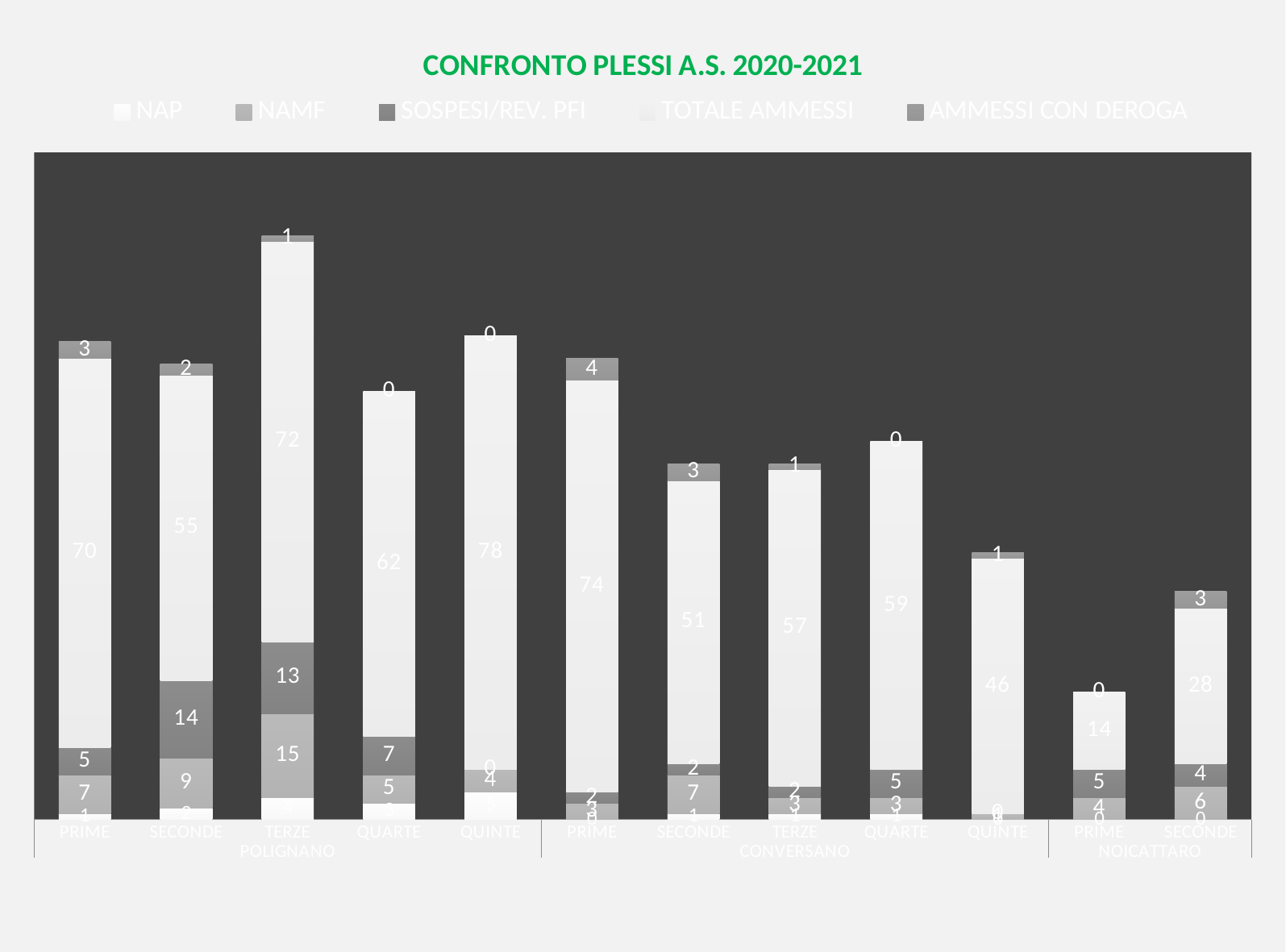
What is the TOTALE AMMESSI value for PRIME in CONVERSANO? 74 What is the title of the chart? CONFRONTO PLESSI A.S. 2020-2021 Which class group has the lowest TOTALE AMMESSI value? PRIME (NOICATTARO) Which is larger: the NAMF value for TERZE in POLIGNANO or the NAMF value for SECONDE in POLIGNANO? TERZE in POLIGNANO What is the AMMESSI CON DEROGA value for PRIME in CONVERSANO? 4 How many class groups (bars) are plotted across the three plessi? 12 What type of chart is shown on the slide? stacked bar chart What is the TOTALE AMMESSI value for QUINTE in POLIGNANO? 78 What is the difference between the TOTALE AMMESSI values for PRIME in CONVERSANO and PRIME in POLIGNANO? 4 How many series does the legend list? 5 What is the SOSPESI/REV. PFI value for SECONDE in POLIGNANO? 14 Which class group has the highest TOTALE AMMESSI value? QUINTE (POLIGNANO)